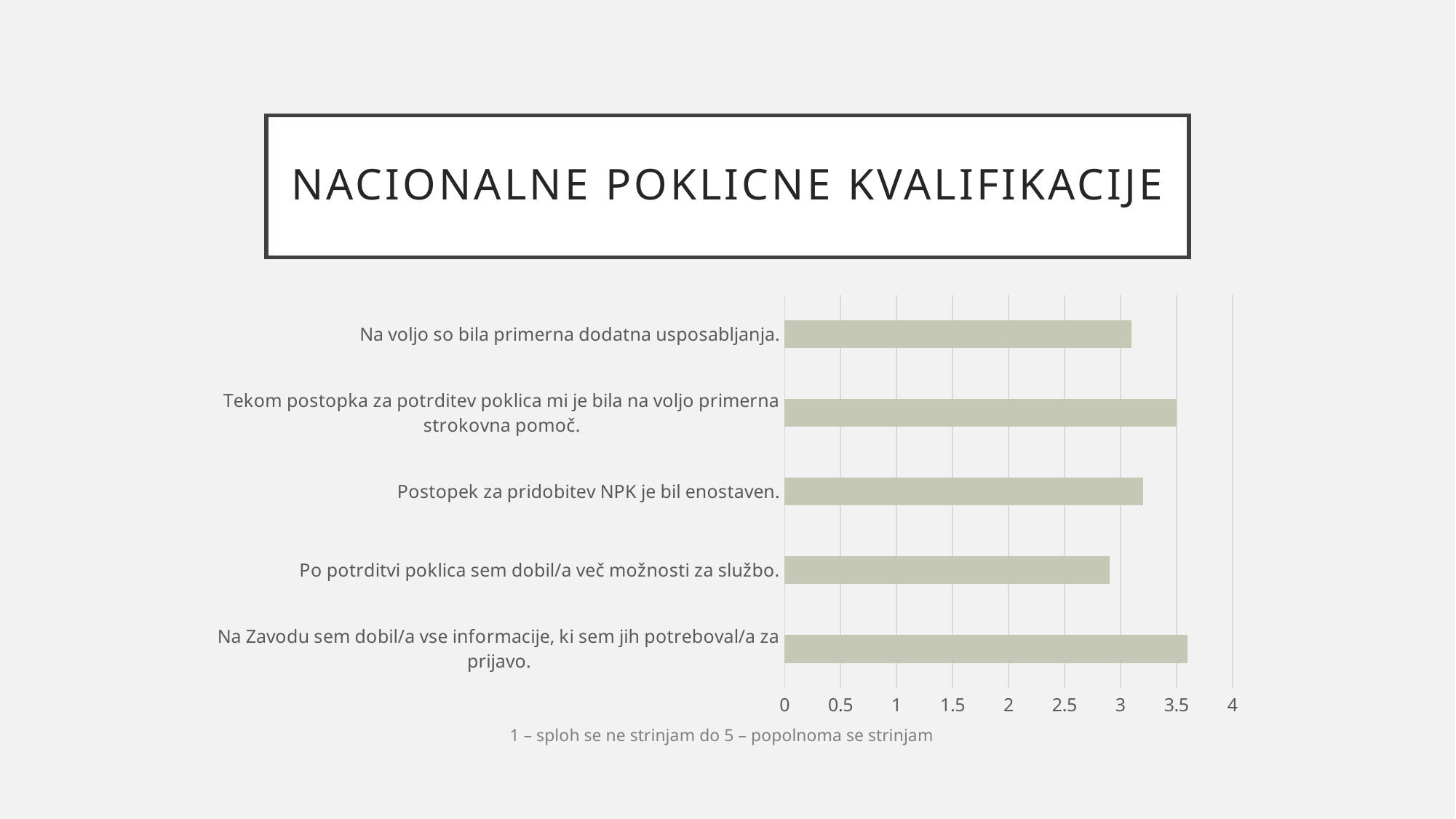
Which has the larger value: "Tekom postopka za potrditev poklica mi je bila na voljo primerna strokovna pomoč." or "Postopek za pridobitev NPK je bil enostaven."? Tekom postopka za potrditev poklica mi je bila na voljo primerna strokovna pomoč. What is the highest tick value shown on the horizontal axis of the chart? 4 How many categories (statements) are plotted in the chart? 5 What is the title shown above the chart on the slide? NACIONALNE POKLICNE KVALIFIKACIJE Is the value for "Na Zavodu sem dobil/a vse informacije, ki sem jih potreboval/a za prijavo." greater or less than 3.5? greater Which has the larger value: "Na Zavodu sem dobil/a vse informacije, ki sem jih potreboval/a za prijavo." or "Po potrditvi poklica sem dobil/a več možnosti za službo."? Na Zavodu sem dobil/a vse informacije, ki sem jih potreboval/a za prijavo. What kind of chart is shown on the slide? bar chart Which statement has the highest value in the chart? Na Zavodu sem dobil/a vse informacije, ki sem jih potreboval/a za prijavo. Is the value for "Po potrditvi poklica sem dobil/a več možnosti za službo." greater or less than 3? less Is the value for "Tekom postopka za potrditev poklica mi je bila na voljo primerna strokovna pomoč." greater or less than 3? greater Which statement has the lowest value in the chart? Po potrditvi poklica sem dobil/a več možnosti za službo.